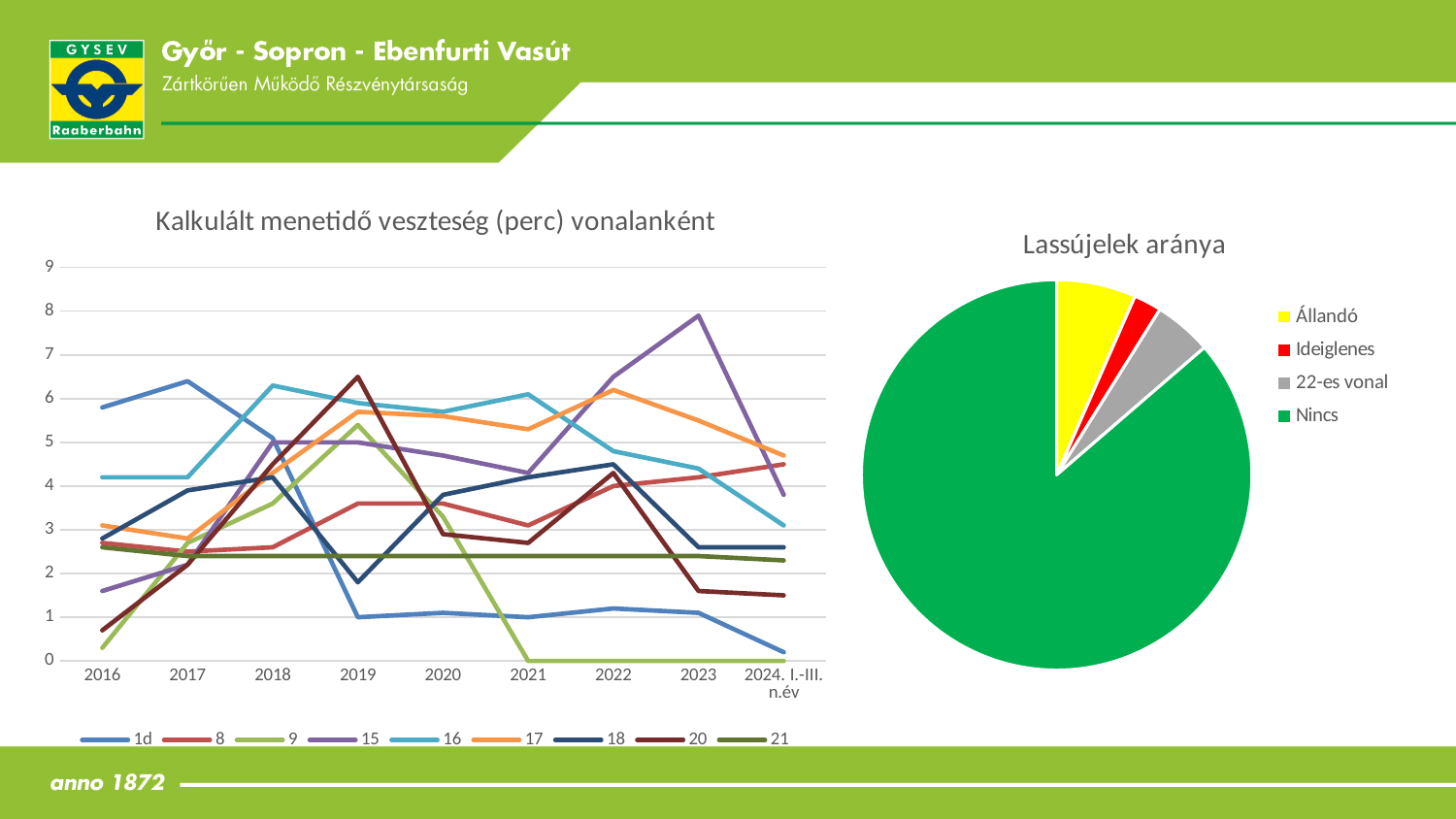
In the line chart "Kalkulált menetidő veszteség (perc) vonalanként", what is the value of series 9 in 2022? 0 In the line chart "Kalkulált menetidő veszteség (perc) vonalanként", how many categories are shown on the x axis? 9 What kind of chart is the chart titled "Kalkulált menetidő veszteség (perc) vonalanként"? line chart What kind of chart is the chart titled "Lassújelek aránya"? pie chart In the line chart "Kalkulált menetidő veszteség (perc) vonalanként", which series has the highest value in 2023? 15 In the line chart "Kalkulált menetidő veszteség (perc) vonalanként", which is larger in 2022: series 17 or series 1d? 17 In the line chart "Kalkulált menetidő veszteség (perc) vonalanként", is the value for series 21 in 2020 greater or less than 3? less In the line chart "Kalkulált menetidő veszteség (perc) vonalanként", is the value for series 15 in 2023 greater or less than 7? greater In the line chart "Kalkulált menetidő veszteség (perc) vonalanként", which series has the lowest value in 2023? 9 In the line chart "Kalkulált menetidő veszteség (perc) vonalanként", does series 9 rise or fall from 2019 to 2021? fall In the pie chart "Lassújelek aránya", which category has the largest slice? Nincs In the line chart "Kalkulált menetidő veszteség (perc) vonalanként", how many series does the legend list? 9